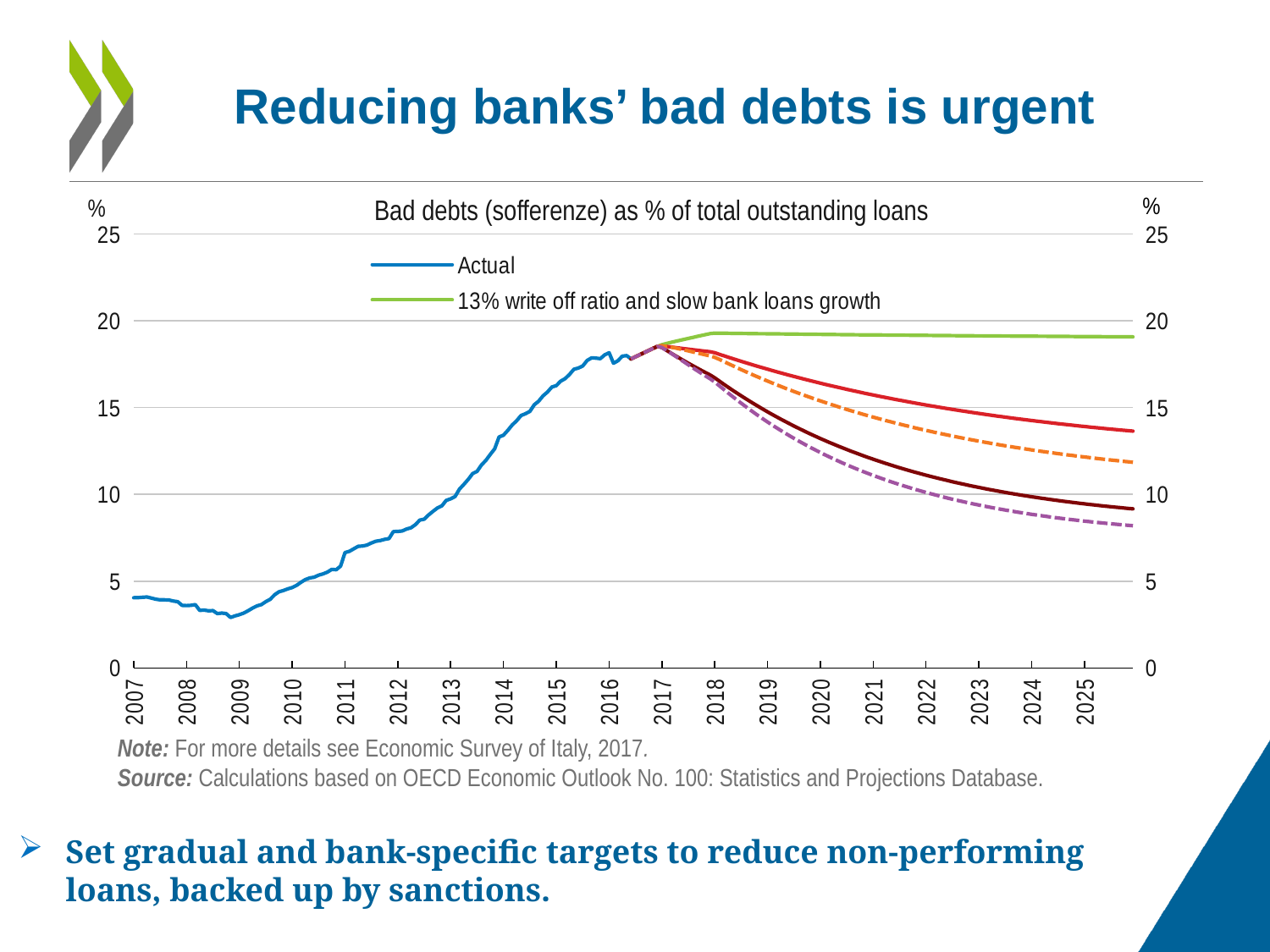
Is the value of the '13% write off ratio and slow bank loans growth' series in 2025 greater or less than 20? less Does the Actual series rise or fall between 2009 and 2017? Rise Is the Actual value in 2009 greater or less than 5? less Which is larger for the Actual series: the value in 2007 or the value in 2016? 2016 What kind of chart is shown on the slide? Line chart Is the Actual value in 2014 greater or less than 10? greater What is the title of the chart? Bad debts (sofferenze) as % of total outstanding loans Which series in the legend is drawn in green? 13% write off ratio and slow bank loans growth In which year is the Actual series at its lowest? 2008 How many series does the chart's legend list? 2